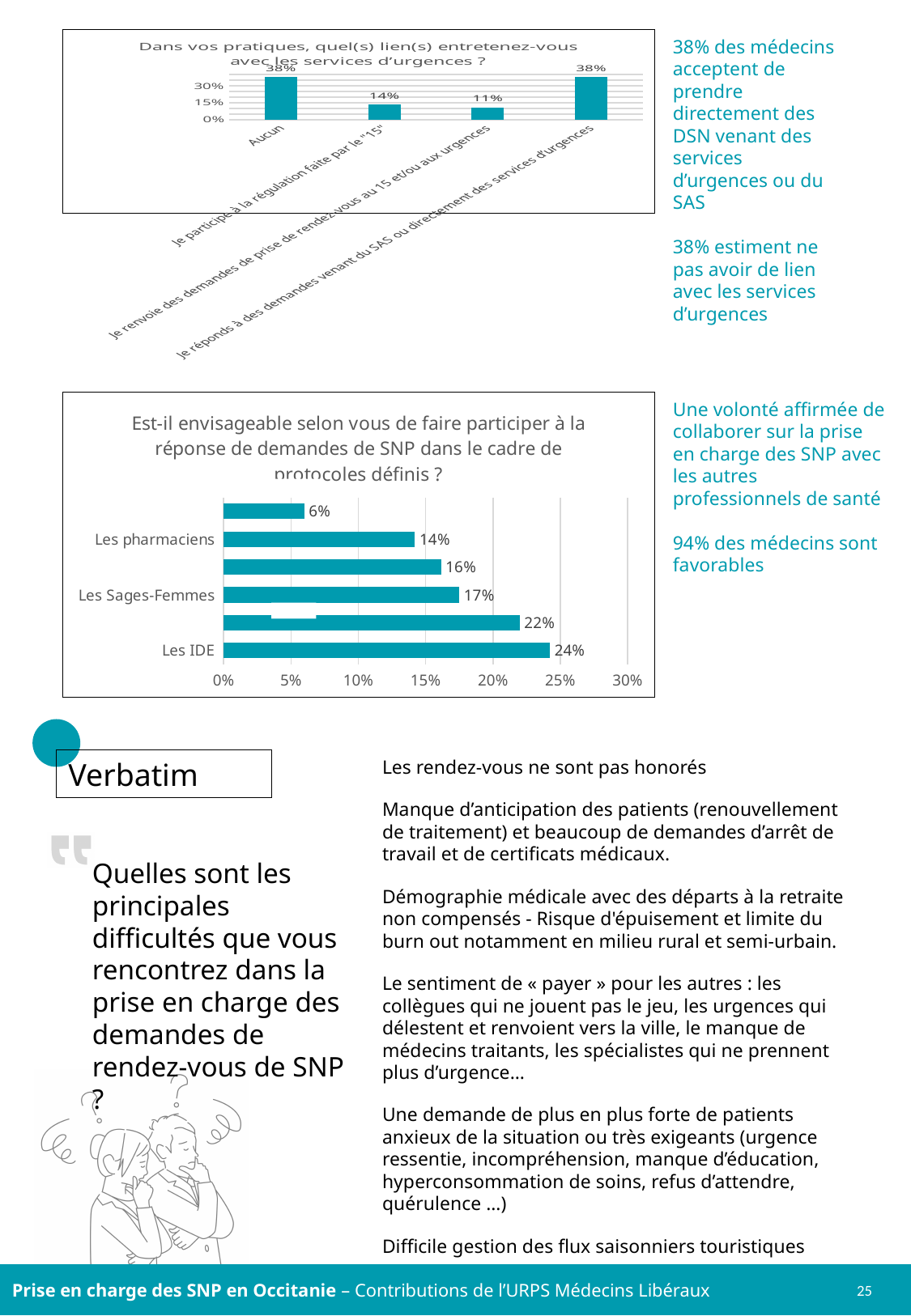
In the top chart 'Dans vos pratiques, quel(s) lien(s) entretenez-vous avec les services d'urgences ?', what is the value for 'Aucun'? 38% In the bottom chart 'Est-il envisageable selon vous de faire participer à la réponse de demandes de SNP dans le cadre de protocoles définis ?', which category has the highest value? Les IDE In the top chart 'Dans vos pratiques, quel(s) lien(s) entretenez-vous avec les services d'urgences ?', what is the difference between the value for 'Aucun' and the value for 'Je renvoie des demandes de prise de rendez-vous au 15 et/ou aux urgences'? 27 percentage points In the bottom chart 'Est-il envisageable selon vous de faire participer à la réponse de demandes de SNP dans le cadre de protocoles définis ?', what is the difference between the value for 'Les IDE' and the value for 'Les Sages-Femmes'? 7 percentage points In the top chart 'Dans vos pratiques, quel(s) lien(s) entretenez-vous avec les services d'urgences ?', how many categories are plotted? 4 In the bottom chart 'Est-il envisageable selon vous de faire participer à la réponse de demandes de SNP dans le cadre de protocoles définis ?', what is the value for 'Les pharmaciens'? 14% In the top chart 'Dans vos pratiques, quel(s) lien(s) entretenez-vous avec les services d'urgences ?', what is the value for 'Je participe à la régulation faite par le "15"'? 14% What kind of chart is the top chart 'Dans vos pratiques, quel(s) lien(s) entretenez-vous avec les services d'urgences ?'? Bar chart In the bottom chart 'Est-il envisageable selon vous de faire participer à la réponse de demandes de SNP dans le cadre de protocoles définis ?', what is the value for 'Les IDE'? 24% In the bottom chart 'Est-il envisageable selon vous de faire participer à la réponse de demandes de SNP dans le cadre de protocoles définis ?', how many bars are plotted? 6 In the top chart 'Dans vos pratiques, quel(s) lien(s) entretenez-vous avec les services d'urgences ?', which category has the lowest value? Je renvoie des demandes de prise de rendez-vous au 15 et/ou aux urgences In the bottom chart 'Est-il envisageable selon vous de faire participer à la réponse de demandes de SNP dans le cadre de protocoles définis ?', what is the value for 'Les Sages-Femmes'? 17%